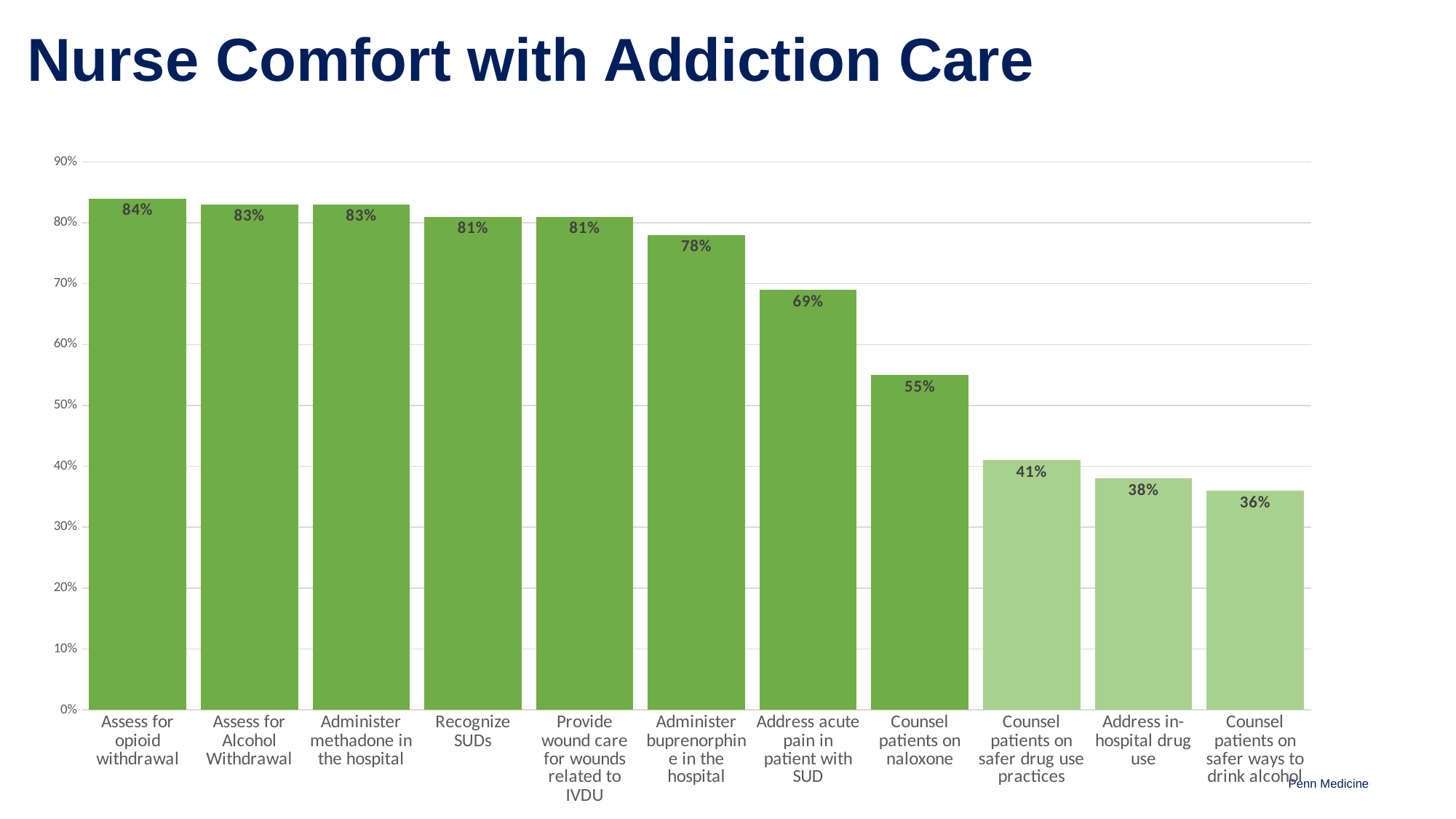
Which category has the lowest value? Counsel patients on safer ways to drink alcohol What is the value for 'Administer buprenorphine in the hospital'? 78% Which is larger: the value for 'Counsel patients on safer drug use practices' or 'Address in-hospital drug use'? Counsel patients on safer drug use practices What is the difference between 'Assess for opioid withdrawal' and 'Counsel patients on safer ways to drink alcohol'? 48% Which category has the highest value? Assess for opioid withdrawal Do the values rise or fall from left to right along the x axis? Fall What percentage of nurses are comfortable assessing for opioid withdrawal? 84% What is the value for 'Counsel patients on naloxone'? 55% What is the difference between 'Address acute pain in patient with SUD' and 'Counsel patients on naloxone'? 14% Is the value for 'Address acute pain in patient with SUD' greater or less than 60%? greater How many categories are shown in the chart? 11 What kind of chart is shown on the slide? Bar chart